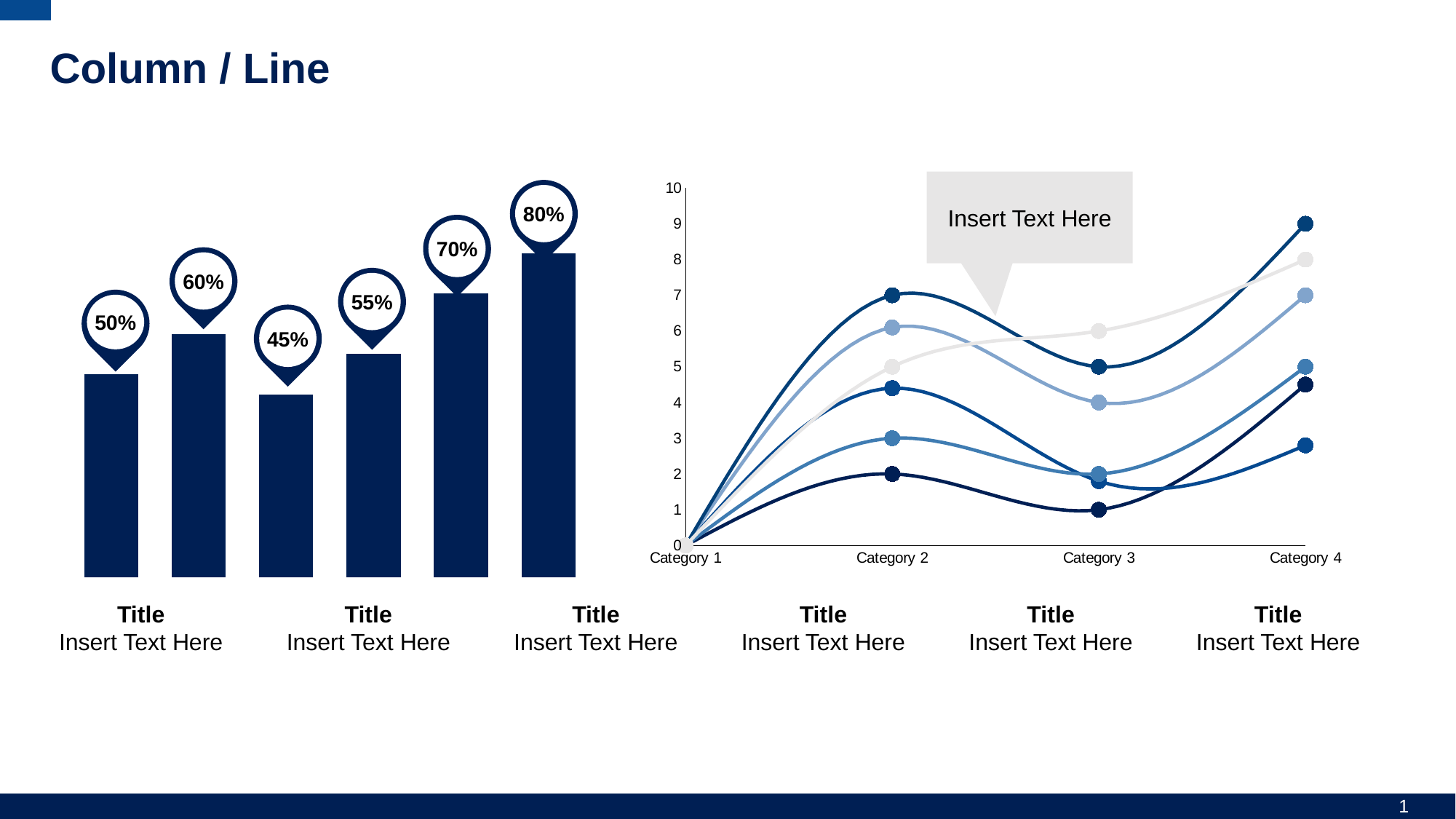
On the left bar chart, what is the difference between the highest and lowest values? 35% What kind of chart is on the right side of the slide? Line chart On the left bar chart, how many bars are there? 6 On the left bar chart, what is the lowest value shown? 45% On the left bar chart, what is the highest value shown? 80% On the left bar chart, which is larger: the second bar or the fourth bar? The second bar (60%) What kind of chart is on the left side of the slide? Bar chart On the right line chart, how many categories are on the x axis? 4 On the left bar chart, what value is shown above the first bar? 50% On the right line chart, what is the highest value reached at Category 4? 9 On the left bar chart, what value is shown above the fifth bar? 70% On the left bar chart, what value is shown above the third bar? 45%